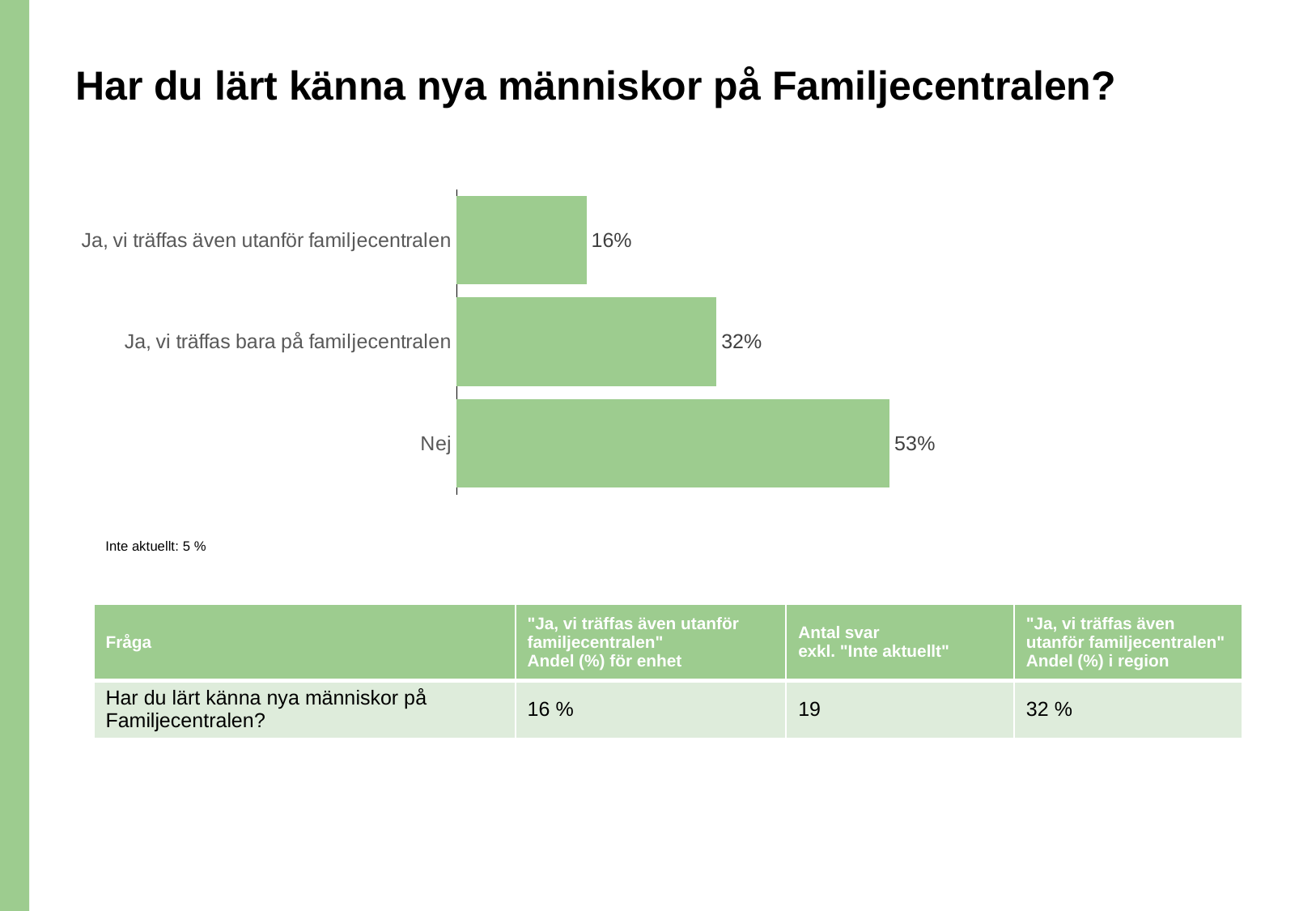
How many categories are shown in the chart? 3 What is the value for "Nej"? 53% Which category has the highest value? Nej What is the value for "Ja, vi träffas även utanför familjecentralen"? 16% What is the difference between the values for "Nej" and "Ja, vi träffas bara på familjecentralen"? 21% What kind of chart is shown on the slide? Bar chart What is the value for "Ja, vi träffas bara på familjecentralen"? 32% Which category has the lowest value? Ja, vi träffas även utanför familjecentralen What colour are the bars in the chart? Green Which is larger, the value for "Nej" or the value for "Ja, vi träffas även utanför familjecentralen"? Nej What is the difference between the values for "Ja, vi träffas bara på familjecentralen" and "Ja, vi träffas även utanför familjecentralen"? 16% What is the title of the slide containing the chart? Har du lärt känna nya människor på Familjecentralen?